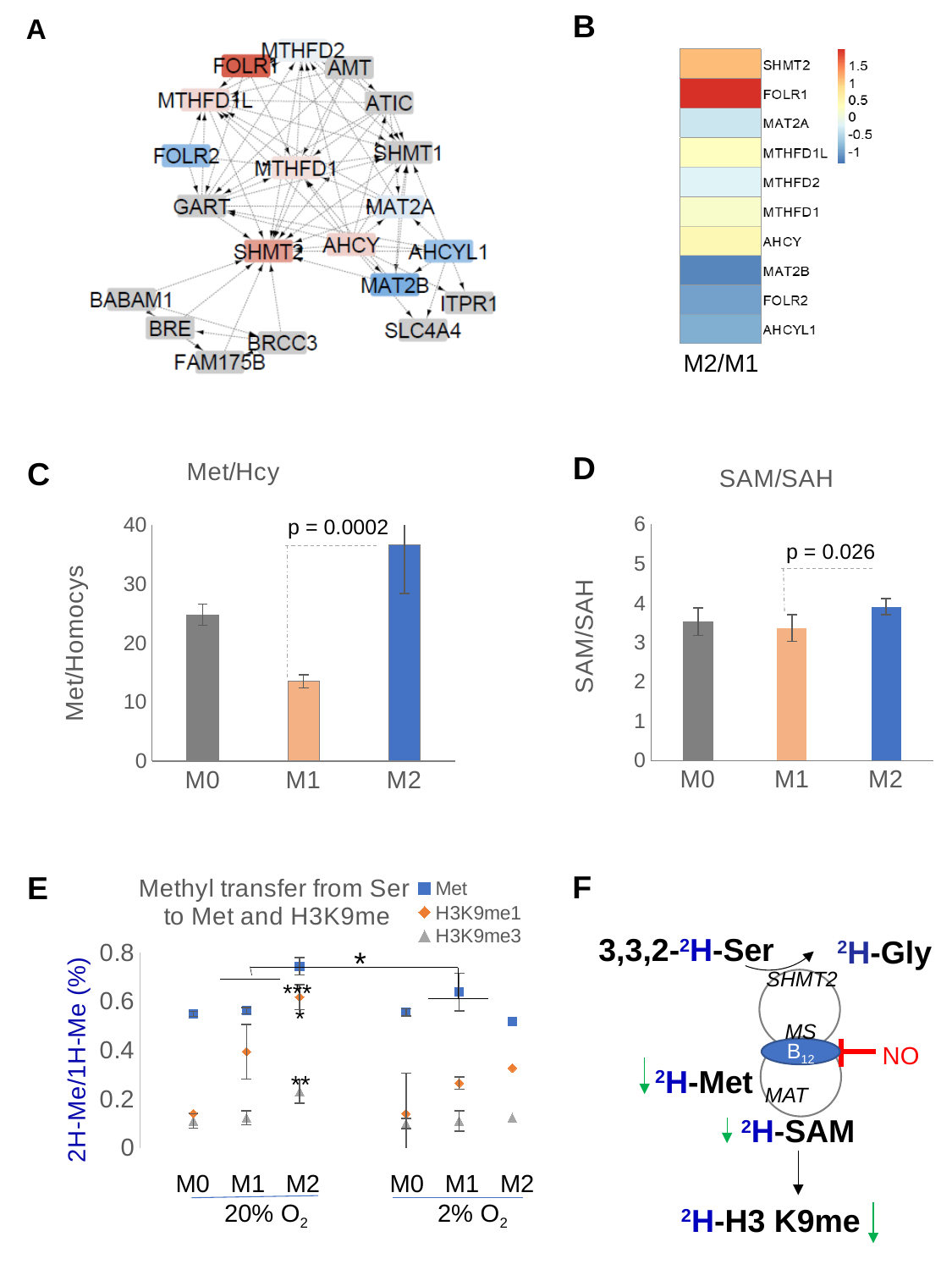
How many series does the legend list in the 'Methyl transfer from Ser to Met and H3K9me' chart (panel E)? 3 In the Met/Hcy chart (panel C), is the value for M1 greater or less than 20? less In the Met/Hcy chart (panel C), which category has the highest value? M2 In the SAM/SAH chart (panel D), is the value for M2 greater or less than 3? greater What kind of chart is the Met/Hcy chart (panel C)? bar chart What p-value is printed on the SAM/SAH chart (panel D)? p = 0.026 How many categories are shown on the x axis of the SAM/SAH chart (panel D)? 3 In the Met/Hcy chart (panel C), which category has the lowest value? M1 In the Met/Hcy chart (panel C), which is larger, the value for M0 or the value for M1? M0 What p-value is printed on the Met/Hcy chart (panel C)? p = 0.0002 In the SAM/SAH chart (panel D), is the value for M1 greater or less than 4? less